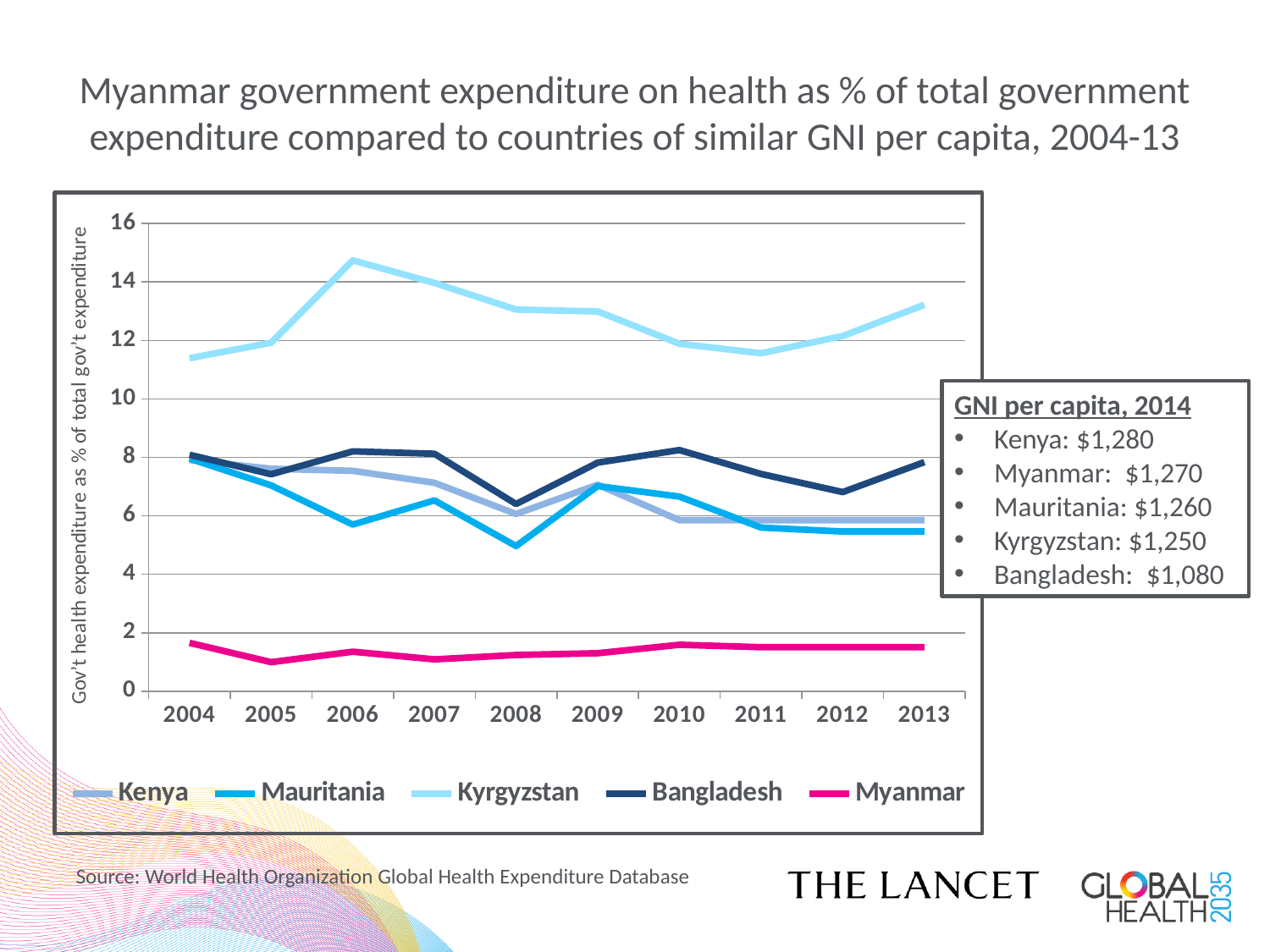
How many years are plotted along the x axis of the chart? 10 Which country has the lowest government health expenditure as % of total government expenditure across 2004-13? Myanmar Is the value for Myanmar in 2013 greater or less than 2? less What is the label on the y axis of the chart? Gov't health expenditure as % of total gov't expenditure How many countries (series) does the chart legend list? 5 Does the Kyrgyzstan line rise or fall between 2006 and 2011? fall In 2008, which is larger: the value for Bangladesh or the value for Mauritania? Bangladesh Is the value for Kyrgyzstan in 2004 greater or less than 12? less What type of chart is shown on the slide? line chart Is the value for Mauritania in 2008 greater or less than 6? less Which country has the highest government health expenditure as % of total government expenditure in 2006? Kyrgyzstan